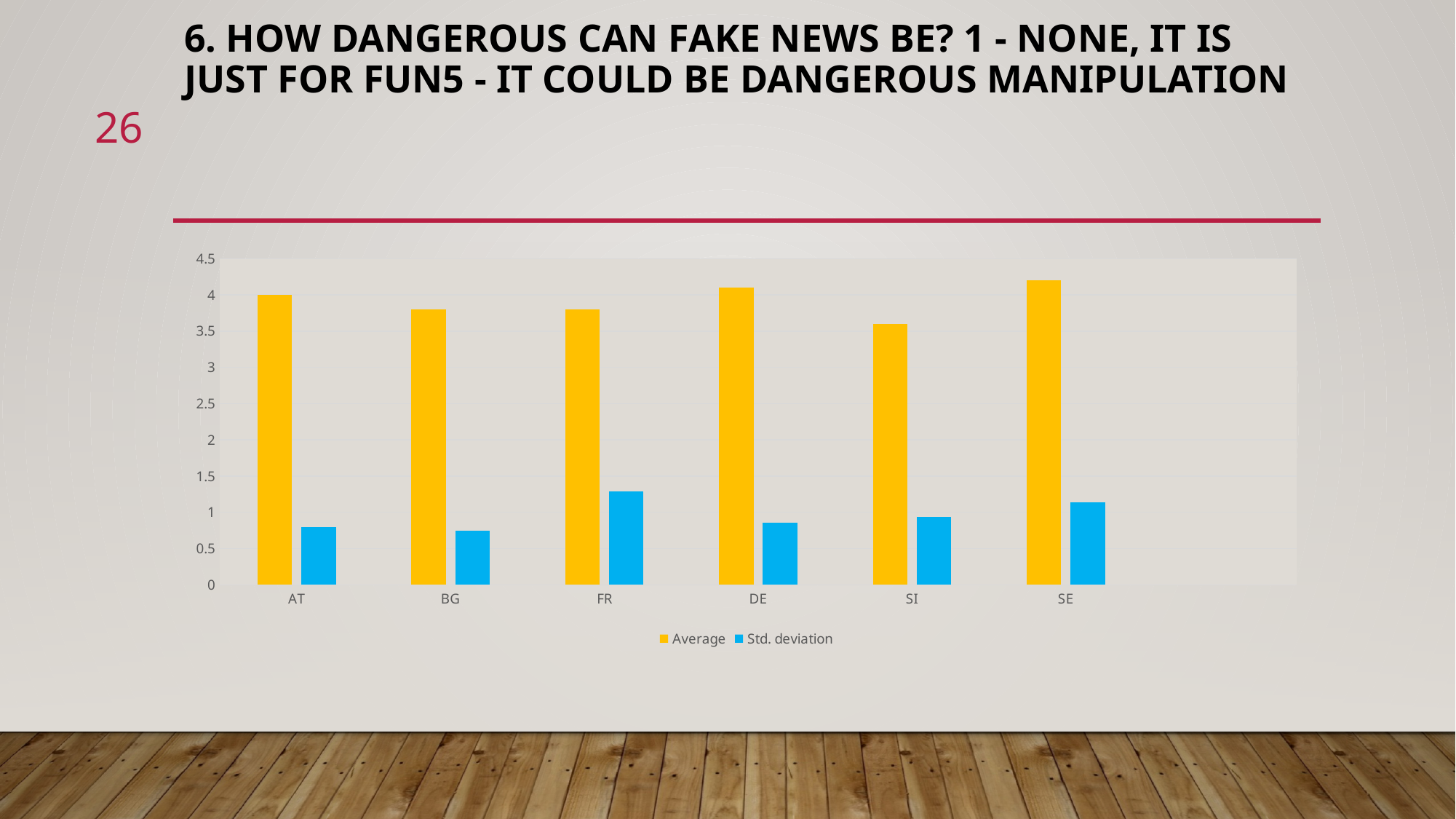
Which is larger, the Average value for DE or for SI? DE How many series does the chart legend list? 2 Which country has the highest Average value? SE How many countries are shown on the x axis of the chart? 6 Is the Std. deviation value for AT greater or less than 1? less Which colour represents the Average series in the chart? yellow Is the Average value for DE greater or less than 4? greater Is the Average value for SI greater or less than 4? less Which country has the lowest Average value? SI Which country has the highest Std. deviation value? FR What type of chart is shown on the slide? bar chart